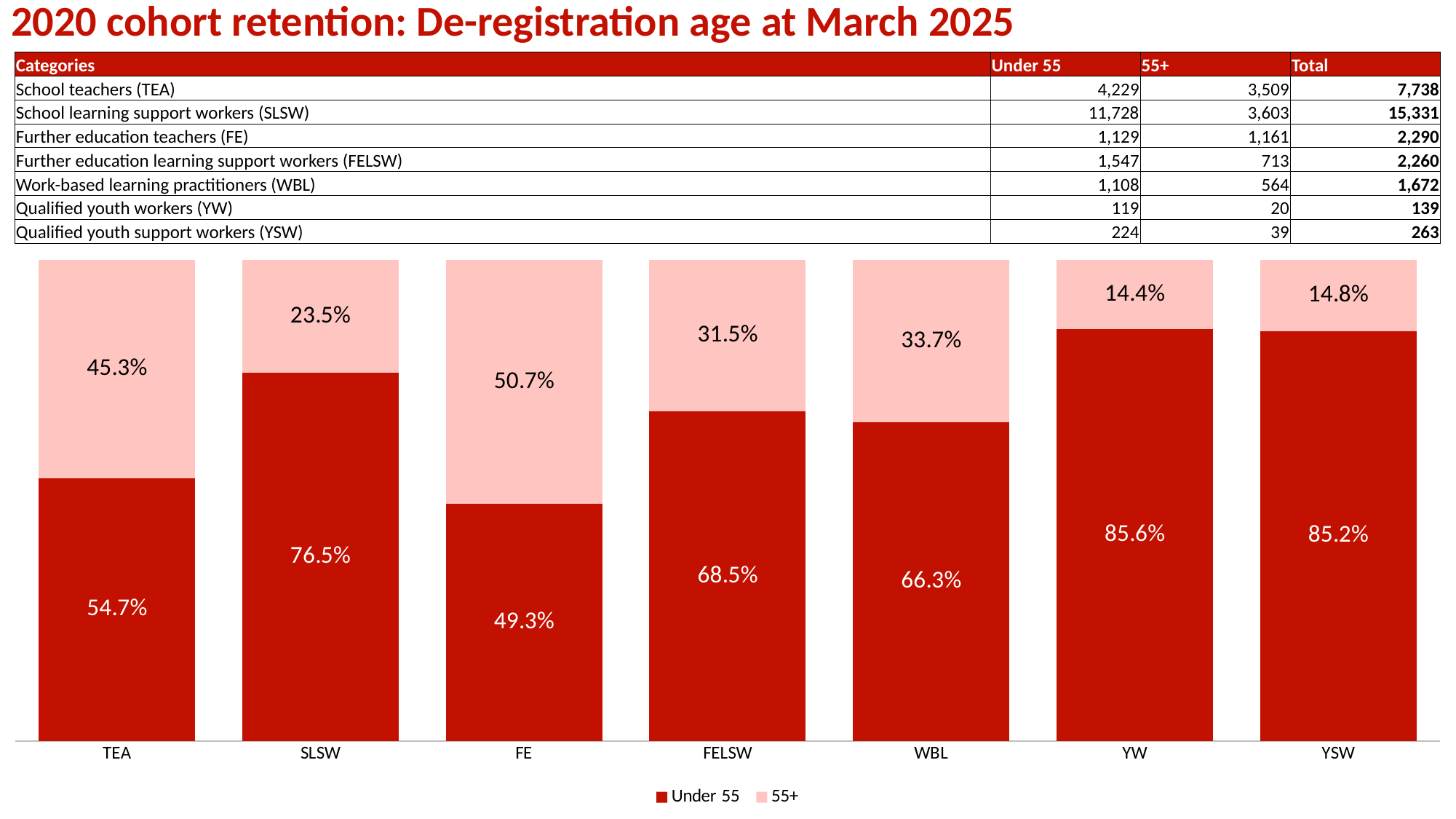
How many categories are shown on the x axis of the chart? 7 What is the Under 55 percentage for WBL in the chart? 66.3% What is the 55+ percentage for FE in the chart? 50.7% Which has a larger 55+ percentage, FELSW or WBL? WBL What kind of chart is shown on the slide? Stacked bar chart How many series does the chart legend list? 2 What is the Under 55 percentage for SLSW in the chart? 76.5% Which category has the highest Under 55 percentage in the chart? YW Which category has the lowest Under 55 percentage in the chart? FE Which category has the highest 55+ percentage in the chart? FE What is the difference between the Under 55 percentages for TEA and SLSW? 21.8% What are the two series named in the chart legend? Under 55 and 55+